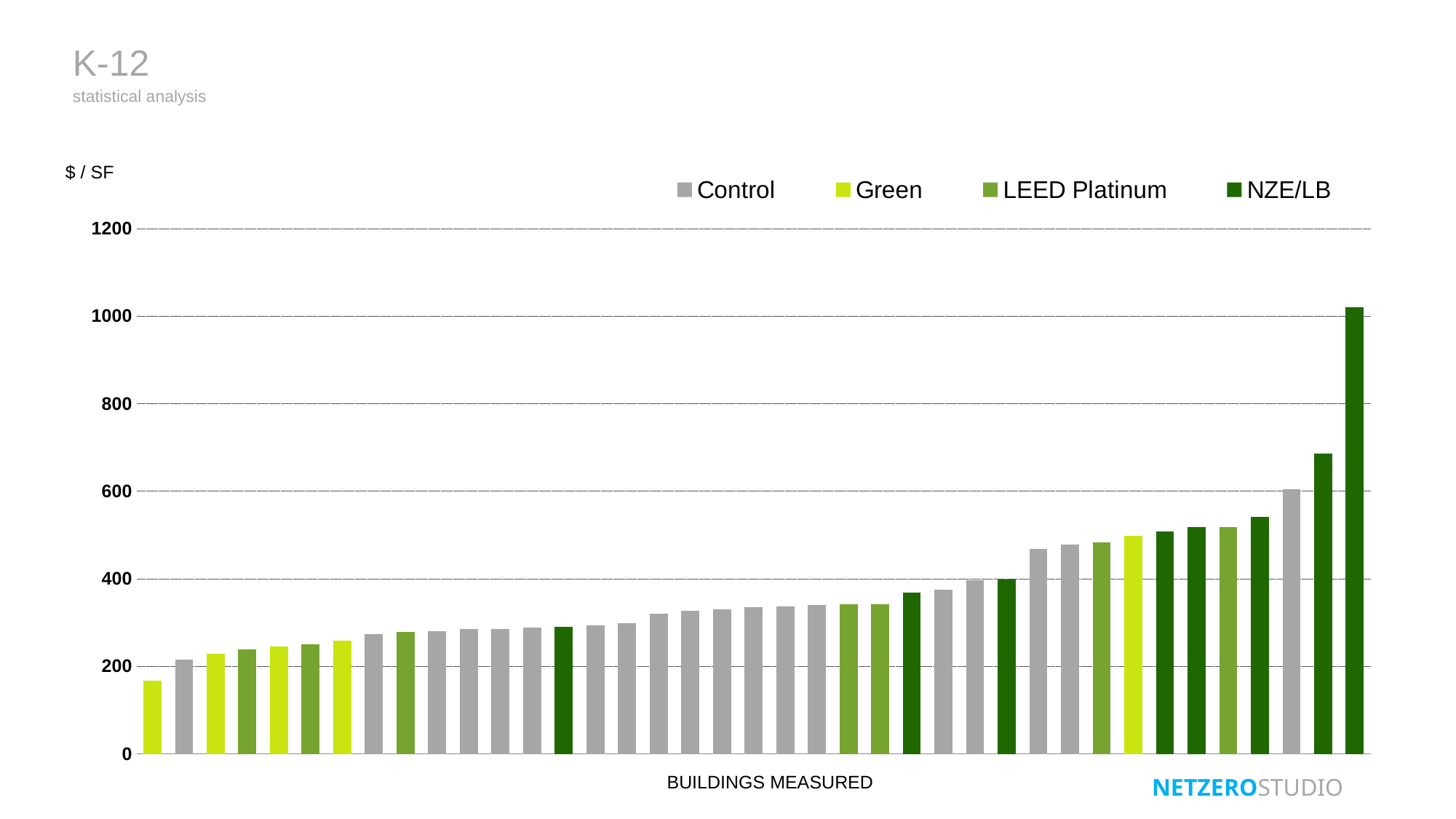
Which series does the shortest bar in the chart belong to? Green Do the bar values rise or fall from left to right along the x axis? Rise What kind of chart is shown on the slide? Bar chart What are the series names listed in the chart legend? Control, Green, LEED Platinum, NZE/LB Is the value of the tallest Control bar greater or less than 400? greater How many series does the chart legend list? 4 What is the highest value shown on the y axis of the chart? 1200 Is the value of the second-tallest bar (the rightmost but one) greater or less than 600? greater Is the value of the shortest bar greater or less than 200? less Which series does the tallest bar in the chart belong to? NZE/LB What is the label on the x axis of the chart? BUILDINGS MEASURED